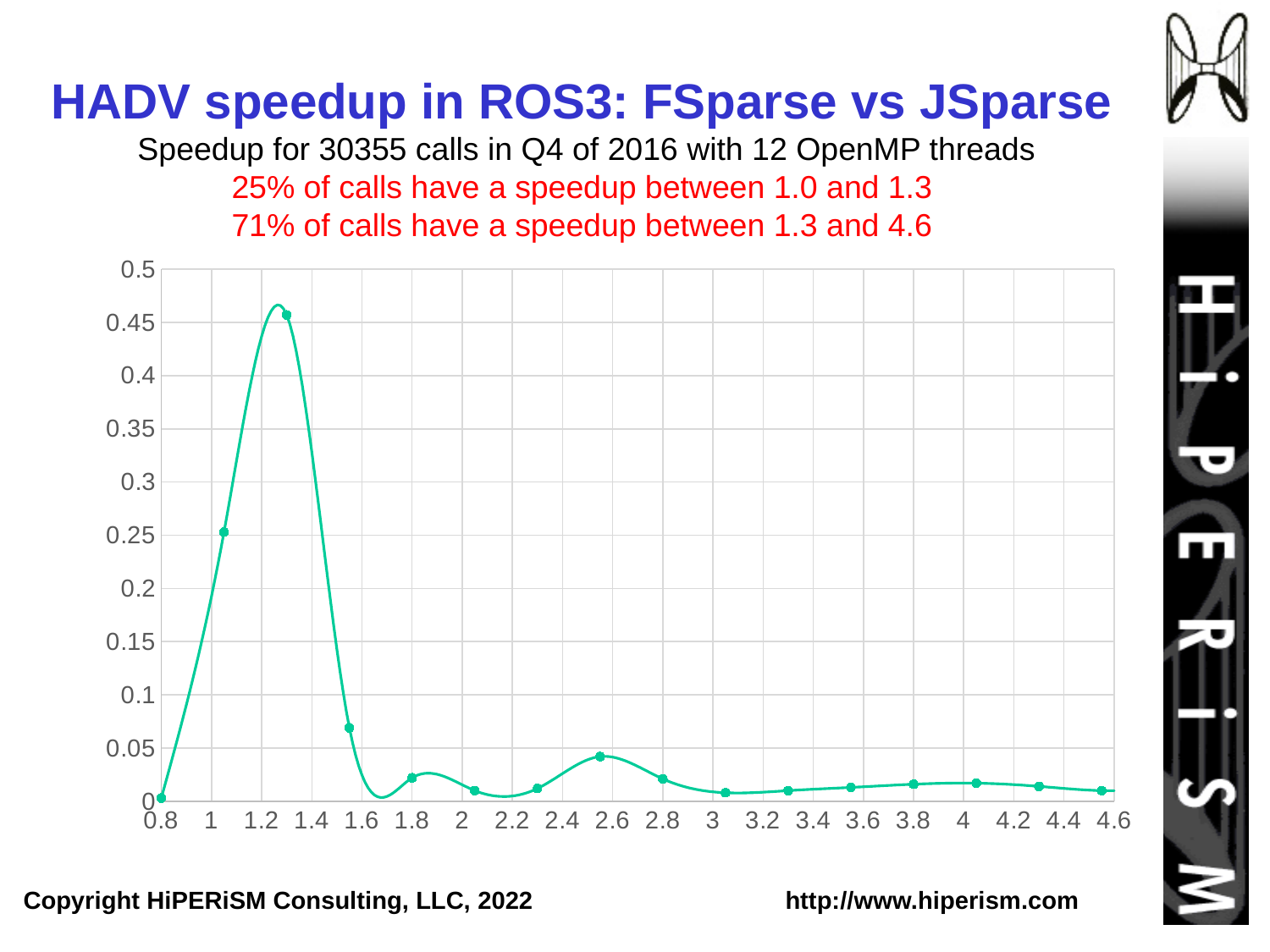
What is the highest value shown on the y axis? 0.5 What kind of chart is shown on the slide? line chart Near which x-axis value does the line reach its highest point? 1.3 Is the value of the point near x = 1.05 greater or less than 0.2? greater How many data points are plotted on the line? 16 Does the line rise or fall between x = 1.3 and x = 1.6? fall Which is larger: the value of the point near x = 2.55 or the value of the point near x = 3.05? the point near x = 2.55 Is the value at the highest point of the line greater or less than 0.4? greater What is the title of the slide's chart? HADV speedup in ROS3: FSparse vs JSparse Which is larger: the value of the point near x = 1.3 or the value of the point near x = 1.05? the point near x = 1.3 Is the value of the point near x = 2.55 greater or less than 0.05? less